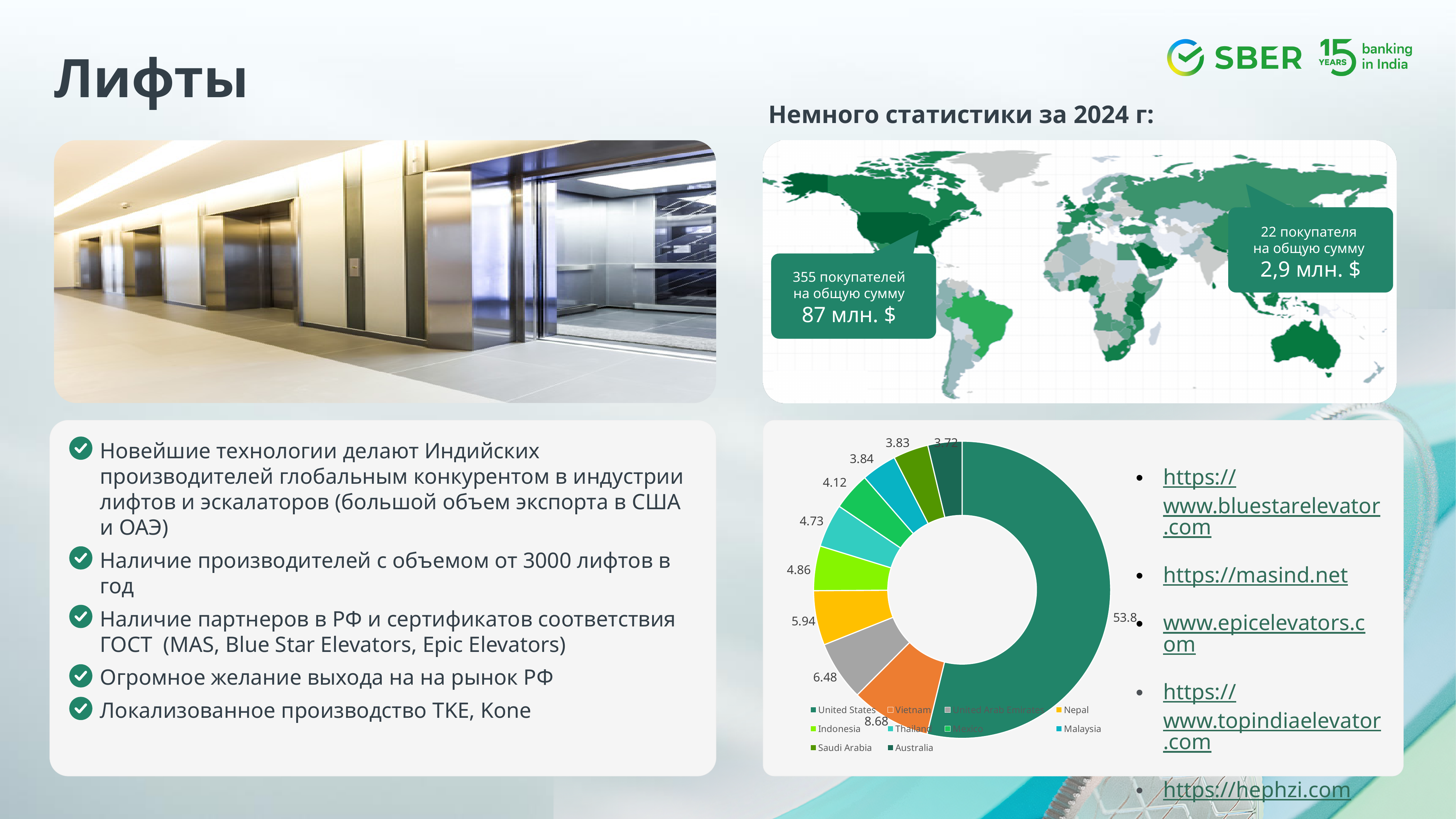
Which country has the largest slice in the pie chart? United States Which country has the smallest slice in the pie chart? Australia How many countries are shown in the pie chart's legend? 10 How many data series does the pie chart's legend represent? 1 Which is larger in the pie chart, the value for Vietnam or the value for Nepal? Vietnam What is the difference between the values for United States and Vietnam in the pie chart? 45.12 What is the value shown for Indonesia in the pie chart? 4.86 What is the value shown for Nepal in the pie chart? 5.94 What is the value shown for United States in the pie chart? 53.8 What is the value shown for Vietnam in the pie chart? 8.68 What kind of chart is shown at the bottom right of the slide? Pie (donut) chart What is the value shown for Thailand in the pie chart? 4.73